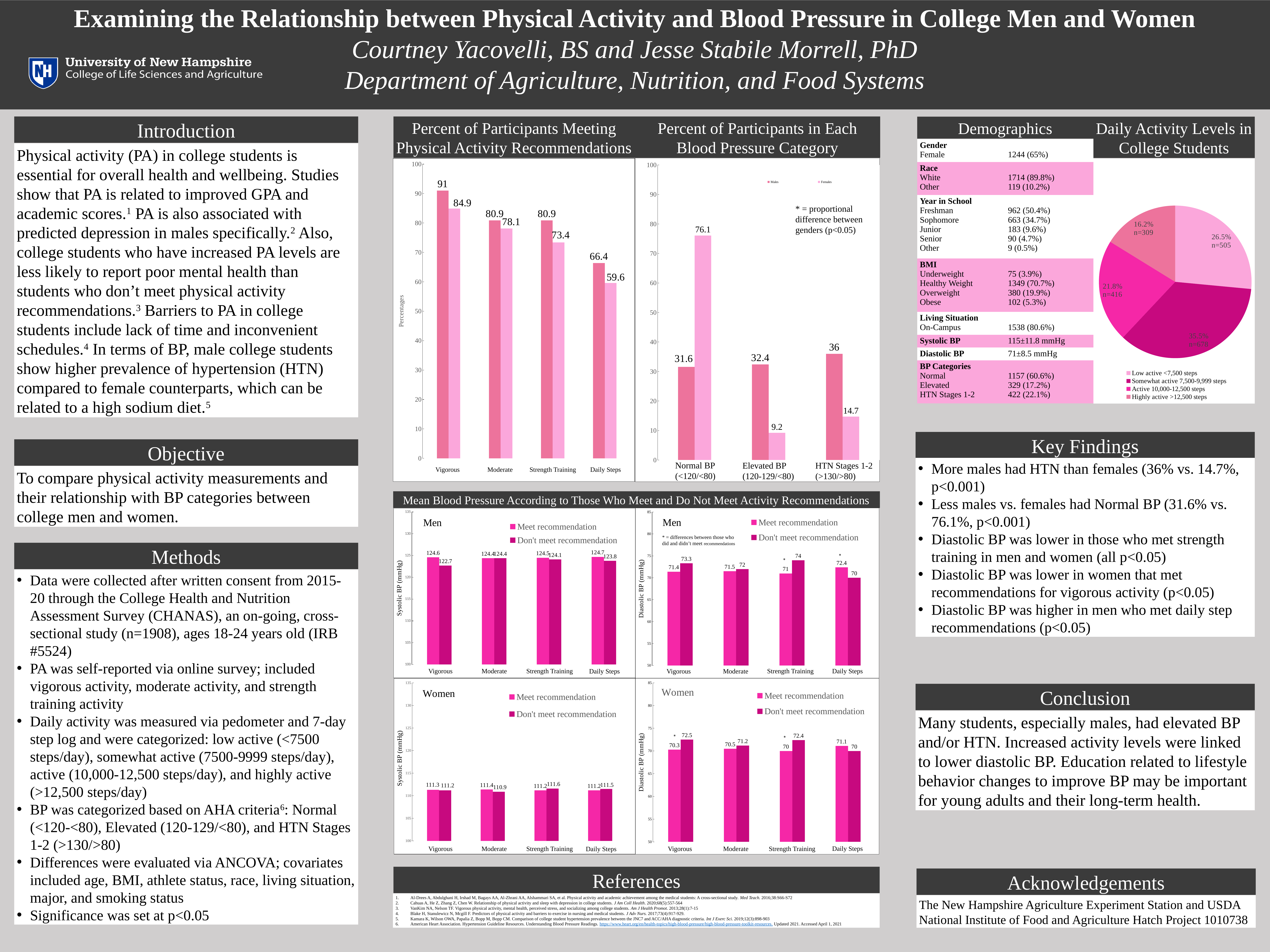
In the chart 'Percent of Participants Meeting Physical Activity Recommendations', what is the value for Females in the Daily Steps category? 59.6 What type of chart is 'Daily Activity Levels in College Students'? Pie chart In the chart 'Percent of Participants in Each Blood Pressure Category', what is the difference between Males and Females in the Elevated BP category? 23.2 In the Men Diastolic BP chart under 'Mean Blood Pressure According to Those Who Meet and Do Not Meet Activity Recommendations', what is the value for 'Don't meet recommendation' in the Strength Training category? 74 In the chart 'Percent of Participants Meeting Physical Activity Recommendations', which category has the lowest value for Males? Daily Steps In the chart 'Percent of Participants in Each Blood Pressure Category', which gender has the larger value for HTN Stages 1-2? Males In the Women Diastolic BP chart under 'Mean Blood Pressure According to Those Who Meet and Do Not Meet Activity Recommendations', what is the value for 'Meet recommendation' in the Vigorous category? 70.3 How many blood pressure categories are shown in the chart 'Percent of Participants in Each Blood Pressure Category'? 3 In the chart 'Percent of Participants in Each Blood Pressure Category', what is the value for Females in the Normal BP category? 76.1 In the chart 'Percent of Participants Meeting Physical Activity Recommendations', what is the value for Males in the Vigorous category? 91 In the pie chart 'Daily Activity Levels in College Students', what share is labelled for the Low active (<7,500 steps) slice? 26.5% In the chart 'Percent of Participants Meeting Physical Activity Recommendations', what is the difference between Males and Females in the Strength Training category? 7.5